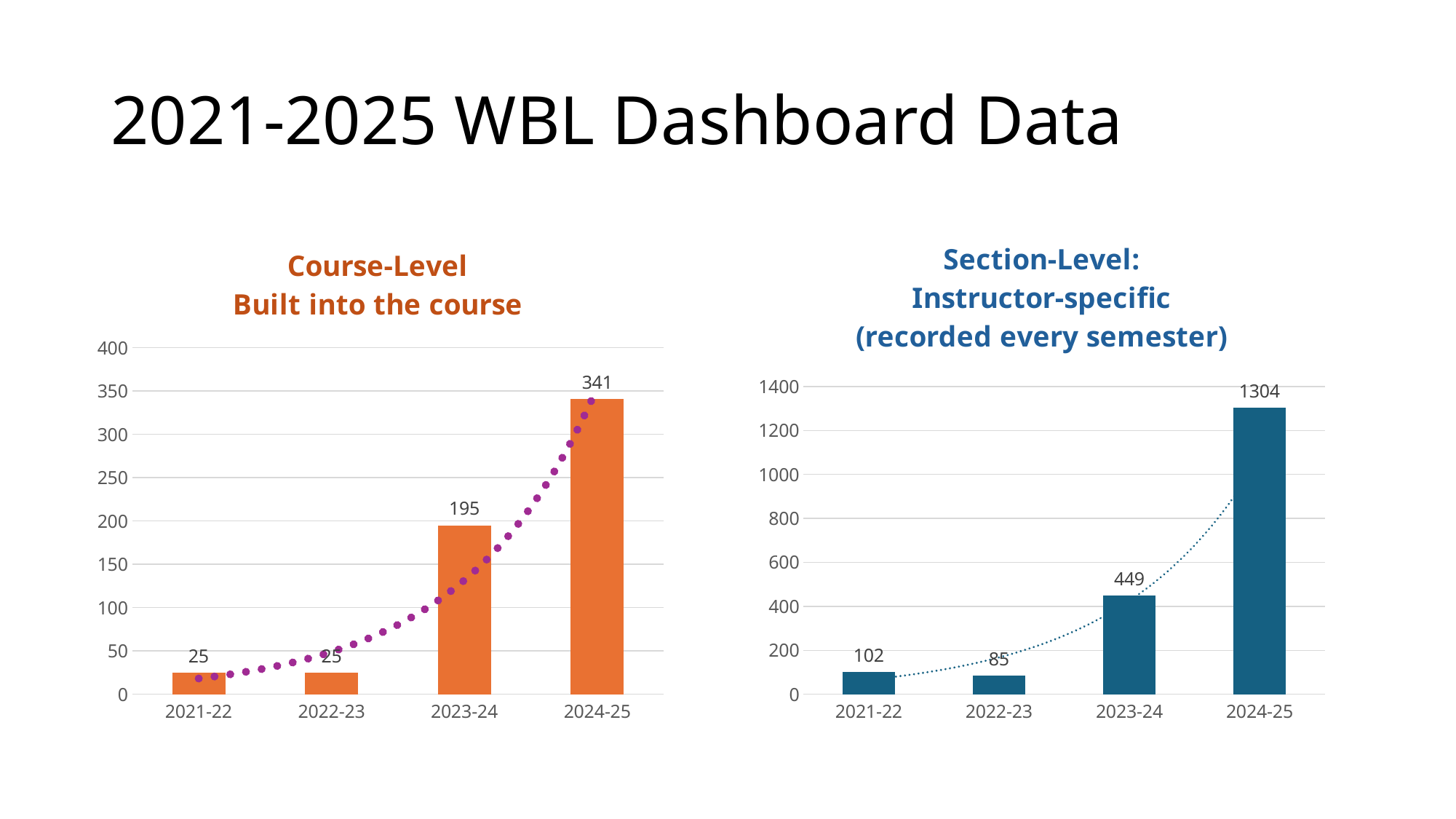
What kind of chart is the Section-Level chart? bar chart In the Course-Level chart, what is the value for 2023-24? 195 In the Section-Level chart, what is the value for 2021-22? 102 In the Course-Level chart, which year has the highest value? 2024-25 In the Course-Level chart, what is the difference between the 2024-25 and 2023-24 values? 146 How many years are shown on the x axis of the Course-Level chart? 4 In the Section-Level chart, what is the value for 2024-25? 1304 In the Section-Level chart, which is larger, the value for 2021-22 or 2022-23? 2021-22 In the Course-Level chart, do the values generally rise or fall from 2021-22 to 2024-25? rise In the Section-Level chart, what is the difference between the 2024-25 and 2023-24 values? 855 In the Course-Level chart, what is the value for 2024-25? 341 In the Section-Level chart, which year has the lowest value? 2022-23